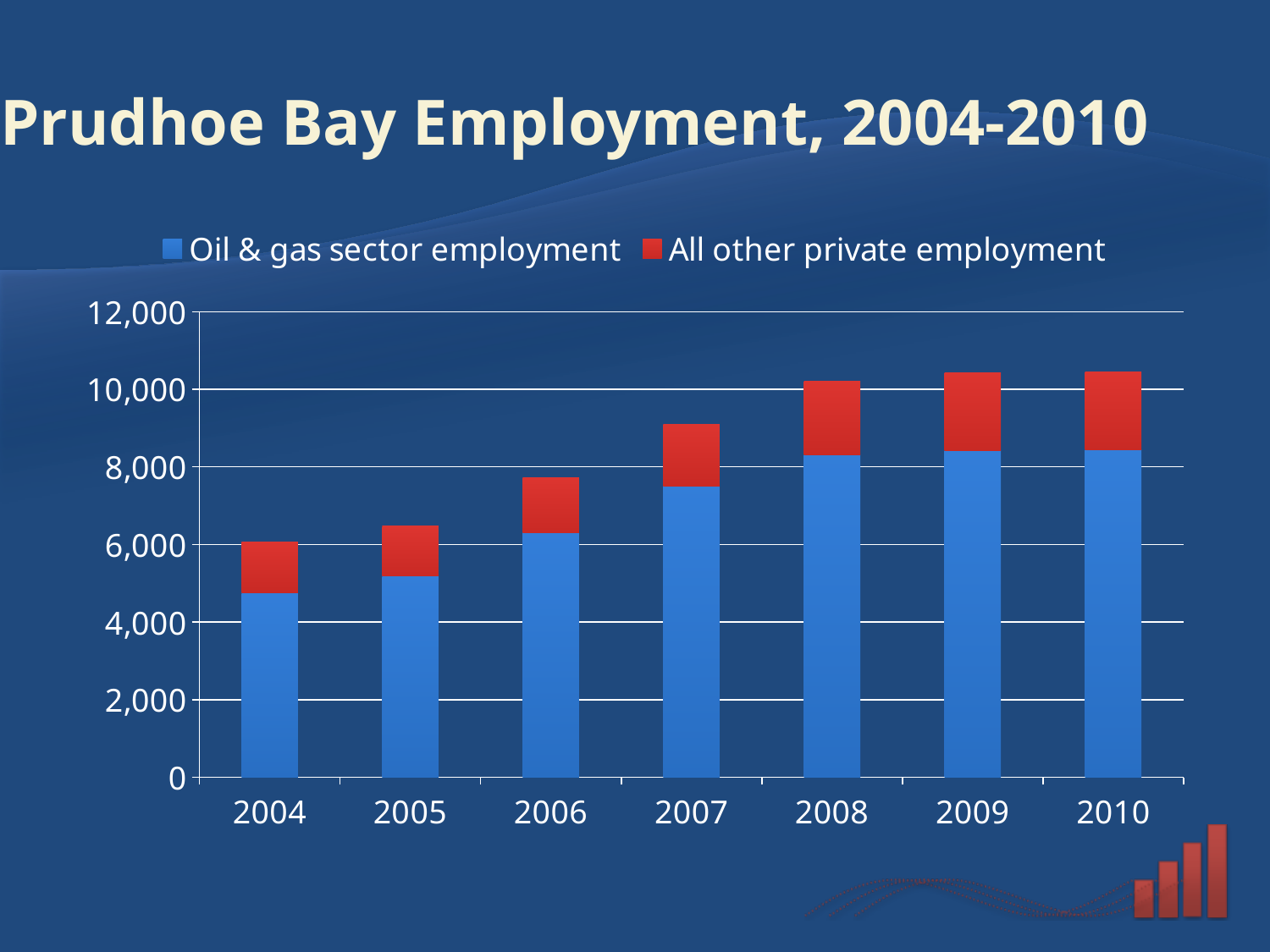
Which colour represents Oil & gas sector employment? Blue Does total employment generally rise or fall from 2004 to 2010? Rise Is the Oil & gas sector employment for 2008 greater or less than 8,000? greater Is the Oil & gas sector employment for 2004 greater or less than 6,000? less What kind of chart is shown on the slide? Stacked bar chart How many years are shown on the x axis? 7 Is the total employment for 2010 greater or less than 10,000? greater What is the title of the chart? Prudhoe Bay Employment, 2004-2010 Which year has the lowest Oil & gas sector employment? 2004 Which is larger, Oil & gas sector employment in 2004 or in 2008? 2008 How many series does the legend list? 2 Which year has the lowest total employment? 2004